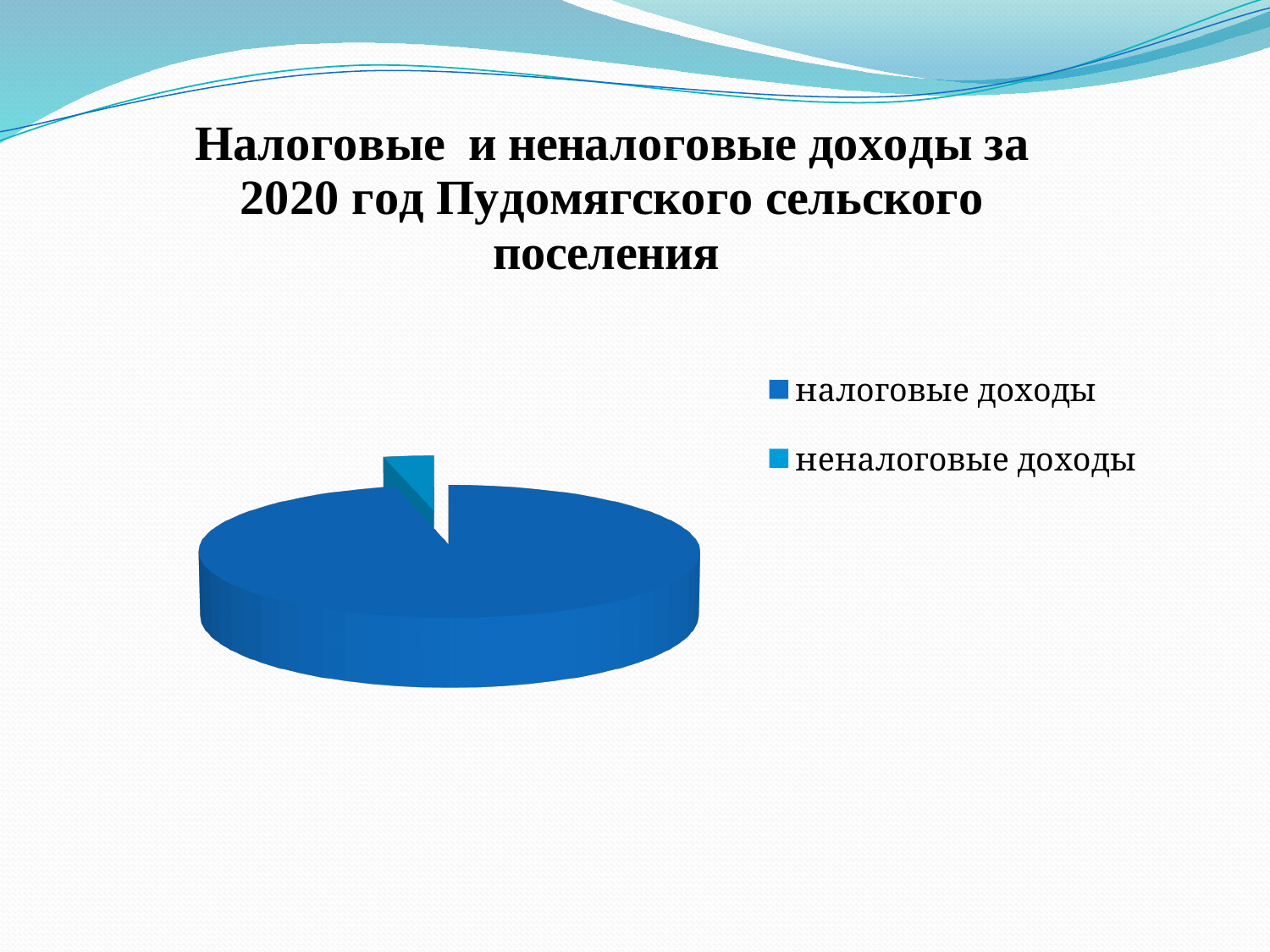
What is the title of the chart on the slide? Налоговые и неналоговые доходы за 2020 год Пудомягского сельского поселения How many slices does the pie chart have? 2 How many entries does the legend of the pie chart list? 2 Which category has the largest slice in the pie chart? налоговые доходы Which legend entry is listed first in the pie chart's legend? налоговые доходы What kind of chart is shown on the slide? pie chart Which category has the smallest slice in the pie chart? неналоговые доходы Which slice is larger: налоговые доходы or неналоговые доходы? налоговые доходы